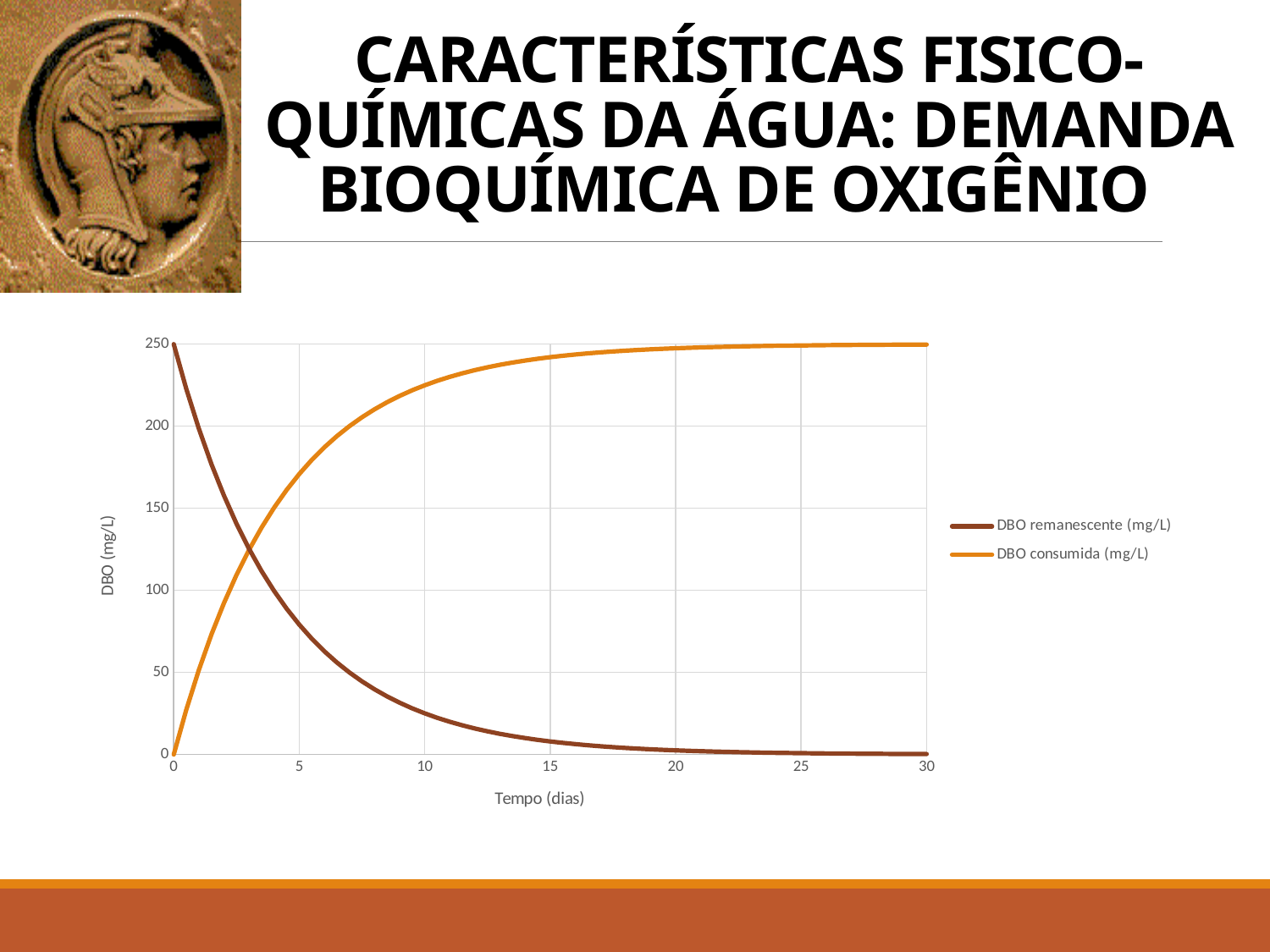
What is the value of DBO remanescente (mg/L) at time 0 days? 250 How many series does the chart legend list? 2 Is the value of DBO remanescente (mg/L) at 15 days greater or less than 50? less Is the value of DBO consumida (mg/L) at 10 days greater or less than 200? greater Is the value of DBO remanescente (mg/L) at 5 days greater or less than 100? less At 10 days, which series has the larger value, DBO remanescente (mg/L) or DBO consumida (mg/L)? DBO consumida (mg/L) Does DBO consumida (mg/L) rise or fall as time increases along the x axis? rise What is the title of the x axis of the chart? Tempo (dias) Does DBO remanescente (mg/L) rise or fall as time increases along the x axis? fall What kind of chart is shown on the slide? line chart What is the value of DBO consumida (mg/L) at time 0 days? 0